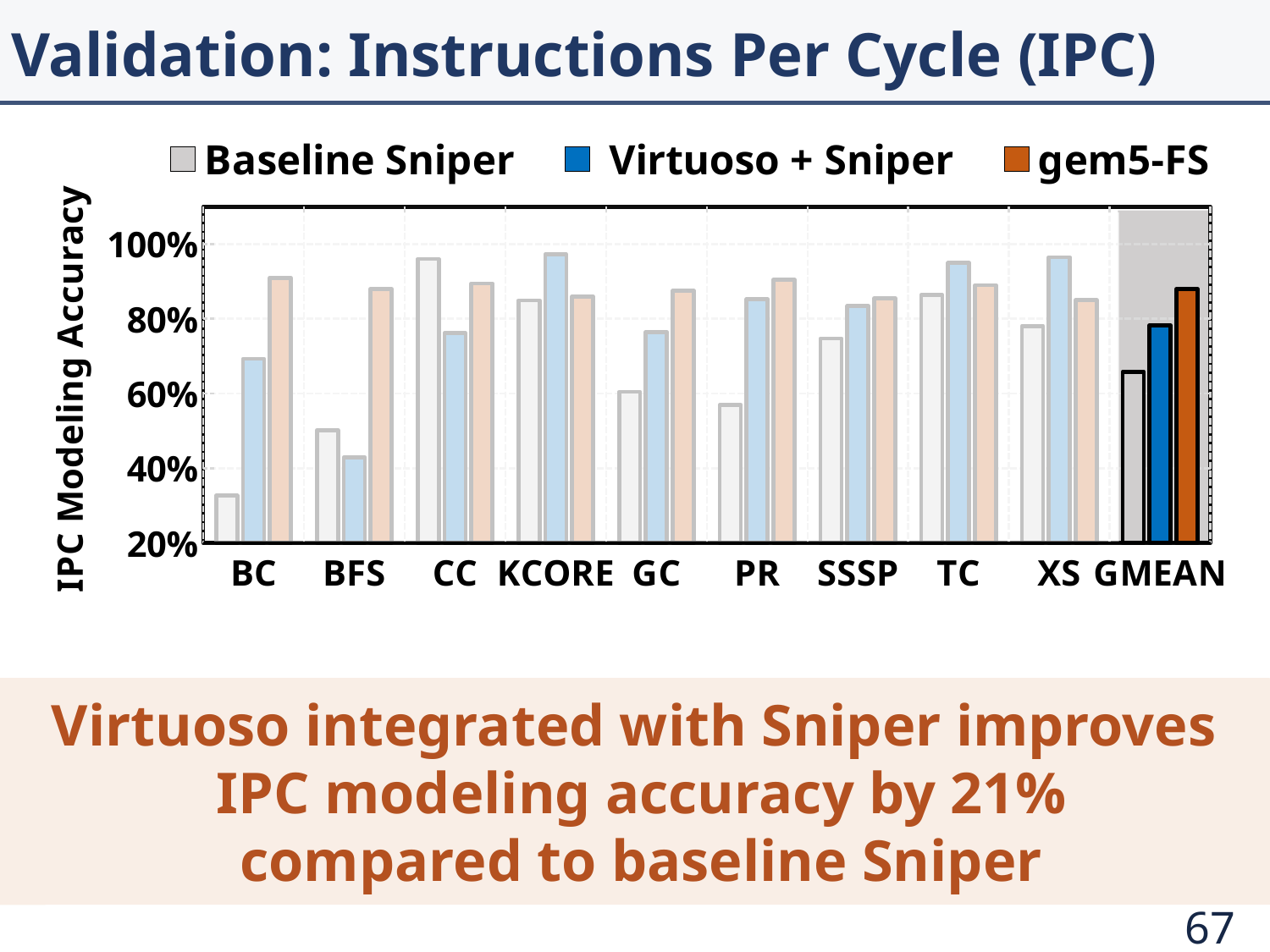
For BC, which is larger: the Virtuoso + Sniper value or the gem5-FS value? gem5-FS For CC, which is larger: the Baseline Sniper value or the Virtuoso + Sniper value? Baseline Sniper How many series does the legend list? 3 Is the Baseline Sniper value for GMEAN greater or less than 60%? greater How many categories are shown on the x axis? 10 Is the Baseline Sniper value for CC greater or less than 80%? greater What is the label of the y axis? IPC Modeling Accuracy Which category has the lowest Virtuoso + Sniper value? BFS Is the Baseline Sniper value for BC greater or less than 40%? less Which category has the lowest Baseline Sniper value? BC What kind of chart is shown on the slide? bar chart